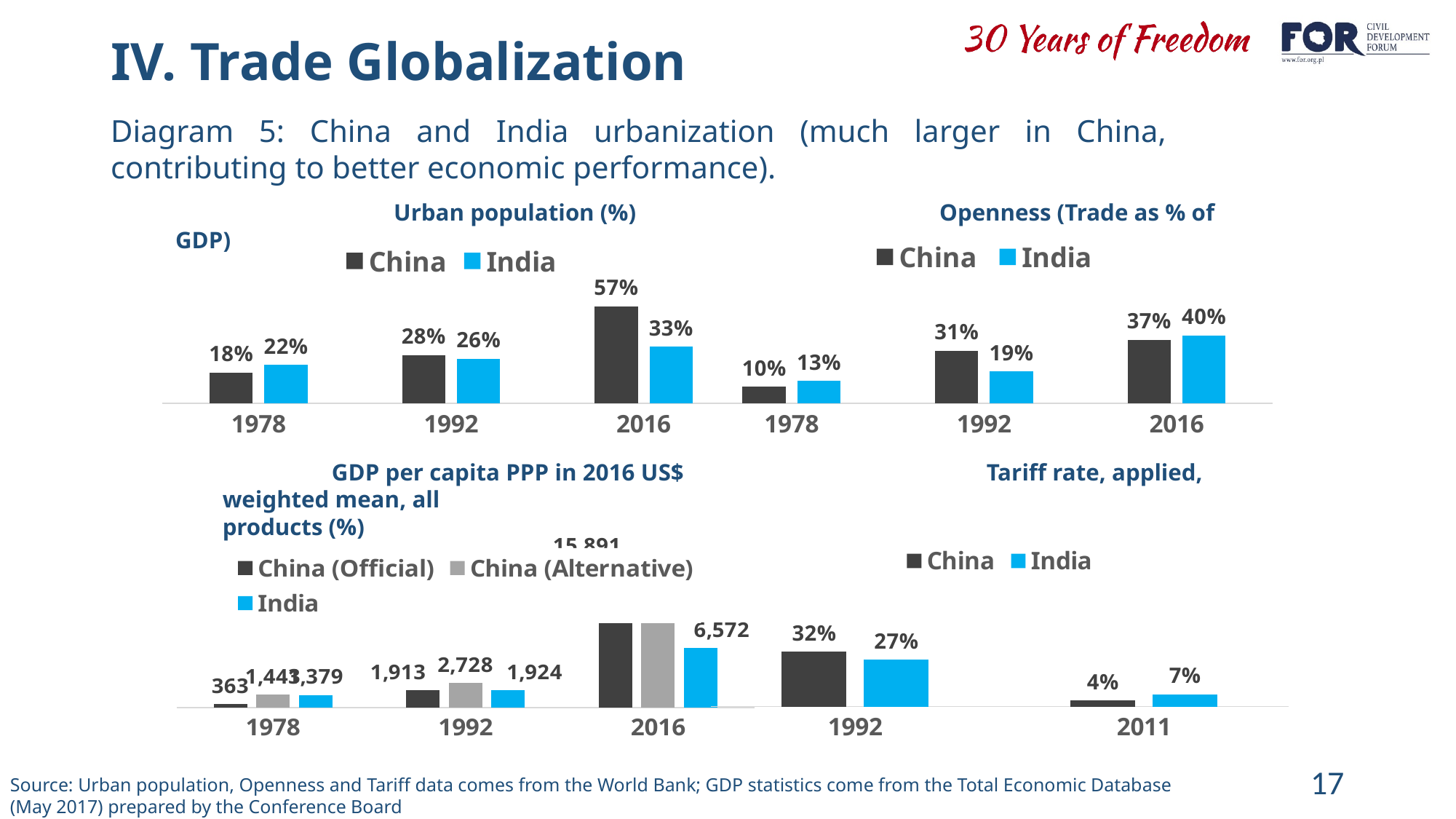
In the Urban population (%) chart, what is the value for China in 2016? 57% In the GDP per capita PPP in 2016 US$ chart, what is the value for India in 2016? 6,572 In the Urban population (%) chart, which is larger in 1992, China or India? China In the Openness (Trade as % of GDP) chart, what is the value for China in 1992? 31% In the Urban population (%) chart, what is the value for India in 1978? 22% How many series does the legend of the GDP per capita PPP in 2016 US$ chart list? 3 In the Openness (Trade as % of GDP) chart, which year has the lowest value for China? 1978 In the GDP per capita PPP in 2016 US$ chart, what is the value for China (Alternative) in 1992? 2,728 In the Tariff rate chart, what is the difference between China and India in 1992? 5% In the Tariff rate chart, what is the value for China in 2011? 4% In the Openness (Trade as % of GDP) chart, what is the value for India in 2016? 40% In the Urban population (%) chart, what is the difference between China and India in 2016? 24%